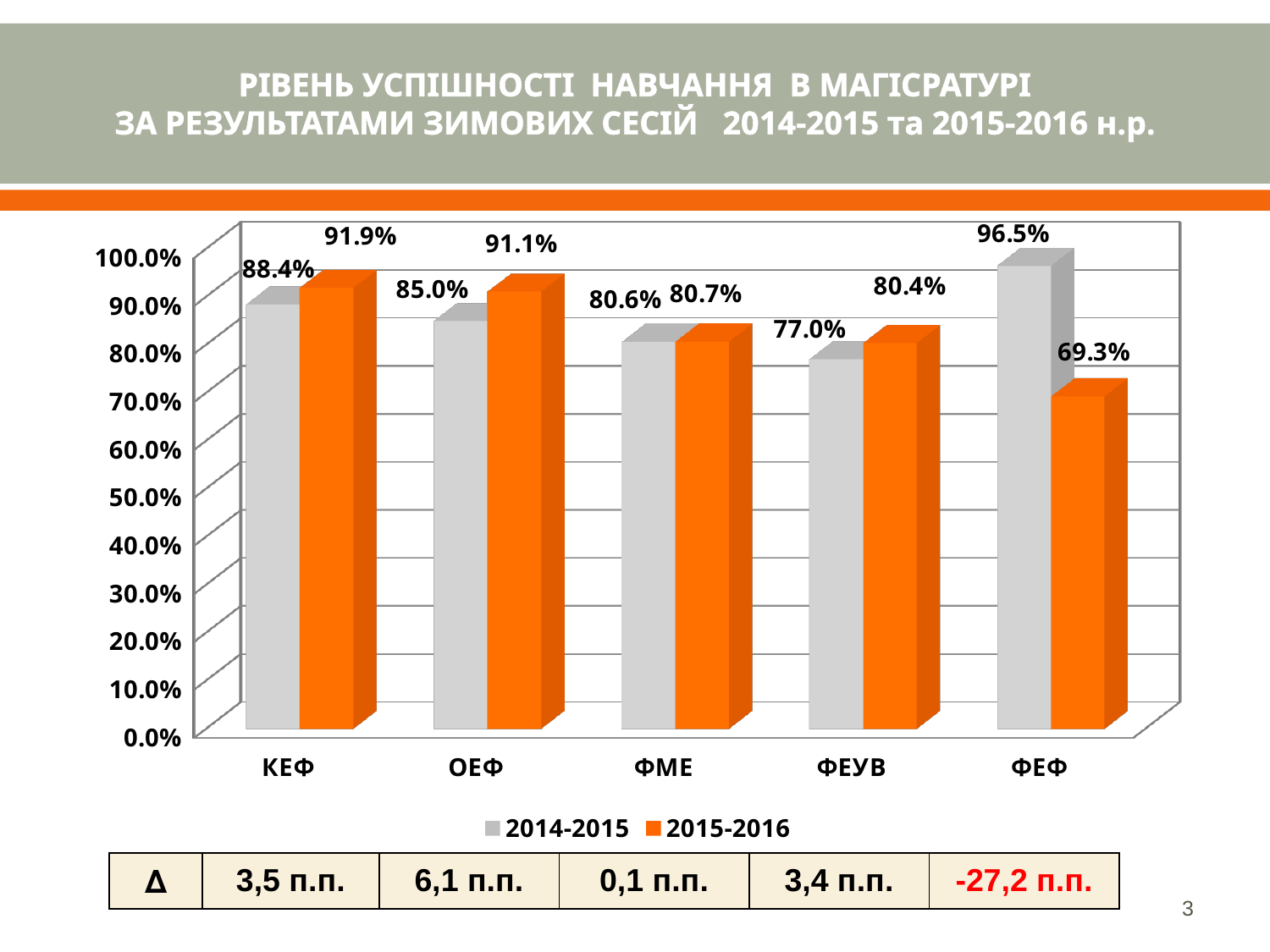
What is the value for КЕФ in the 2015-2016 series? 91.9% Which colour represents the 2015-2016 series? orange What is the difference between the 2014-2015 and 2015-2016 values for ОЕФ? 6.1% What kind of chart is shown on the slide? bar chart How many categories are shown on the x axis? 5 What is the value for ФЕФ in the 2014-2015 series? 96.5% What is the value for ФЕУВ in the 2014-2015 series? 77.0% Which category has the lowest value in the 2015-2016 series? ФЕФ Is the 2015-2016 value for ФЕФ greater or less than 70.0%? less How many series does the legend list? 2 Which category has the highest value in the 2014-2015 series? ФЕФ Which is larger for ФЕФ: the 2014-2015 value or the 2015-2016 value? 2014-2015